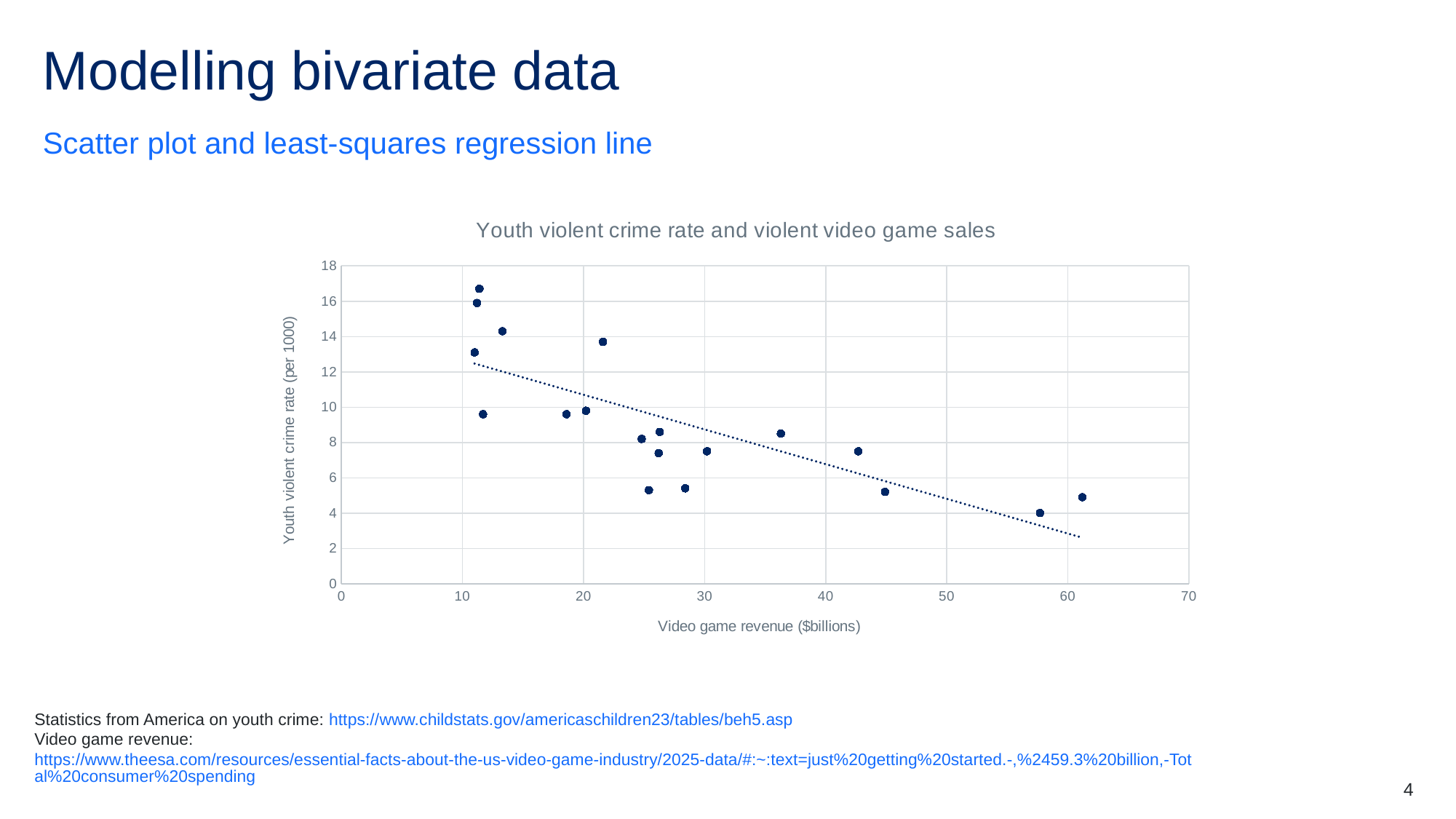
Is the value of the regression line at a video game revenue of 10 greater or less than 10? greater Is the video game revenue for the point with the highest youth violent crime rate greater or less than 20? less Is the youth violent crime rate for the point with the lowest video game revenue greater or less than 12? greater As video game revenue increases along the x axis, does the youth violent crime rate generally rise or fall? Fall Which has the higher youth violent crime rate: the point at about 36 billion revenue or the point at about 45 billion revenue? The point at about 36 billion What is the label of the x axis? Video game revenue ($billions) What kind of chart is shown on the slide? Scatter plot What is the title of the chart? Youth violent crime rate and violent video game sales